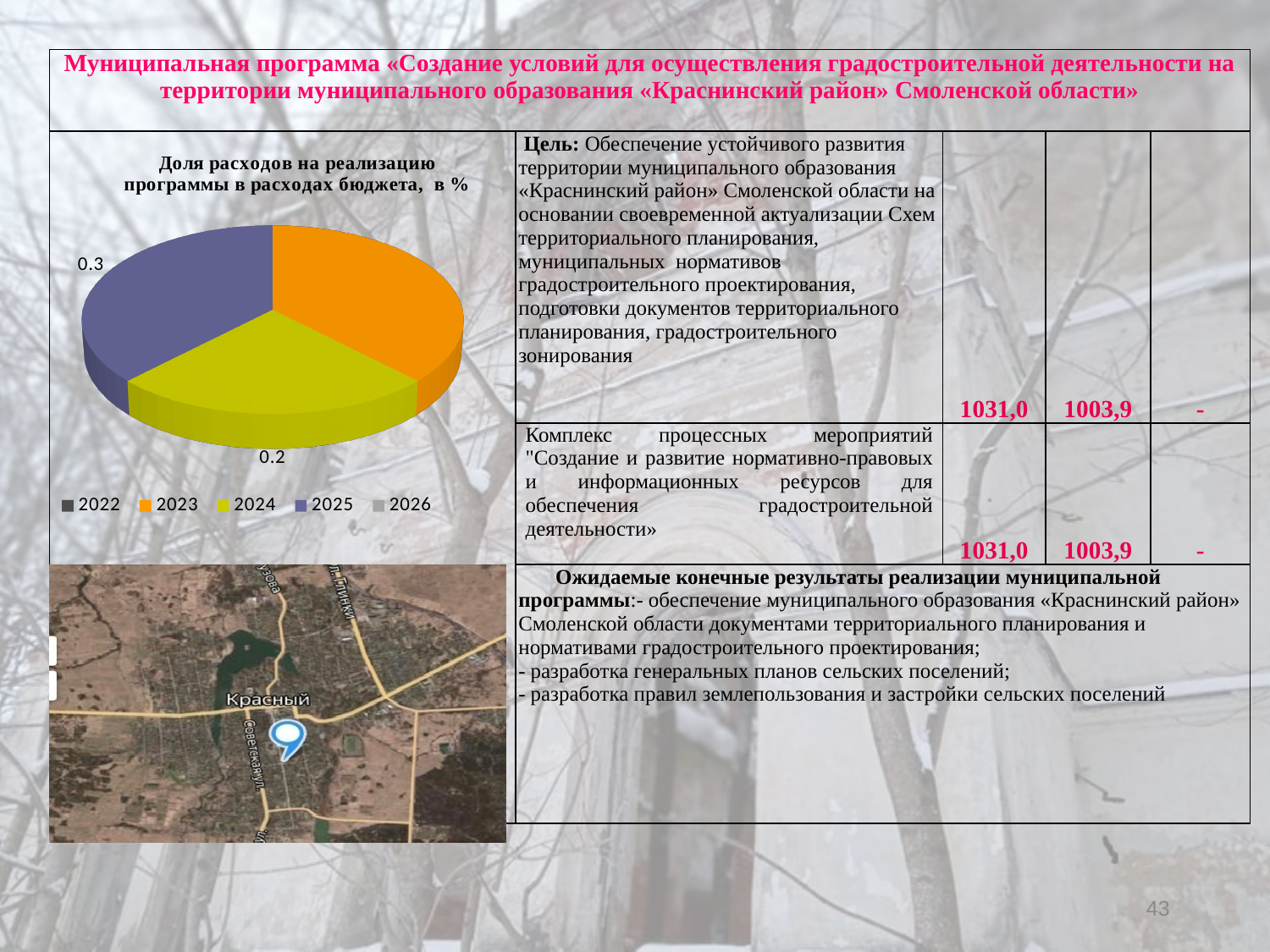
What value is labelled on the 2024 slice of the pie chart? 0.2 Which year's slice in the pie chart carries the data label 0.2? 2024 What value is labelled on the 2025 slice of the pie chart? 0.3 What kind of chart is shown on the slide? pie chart How many slices are visible in the pie chart? 3 How many entries does the legend of the pie chart list? 5 What is the difference between the labelled values for 2025 and 2024 in the pie chart? 0.1 What is the title of the pie chart? Доля расходов на реализацию программы в расходах бюджета, в % Which is larger in the pie chart, the labelled value for 2025 or for 2024? 2025 Which legend entry is shown in orange in the pie chart? 2023